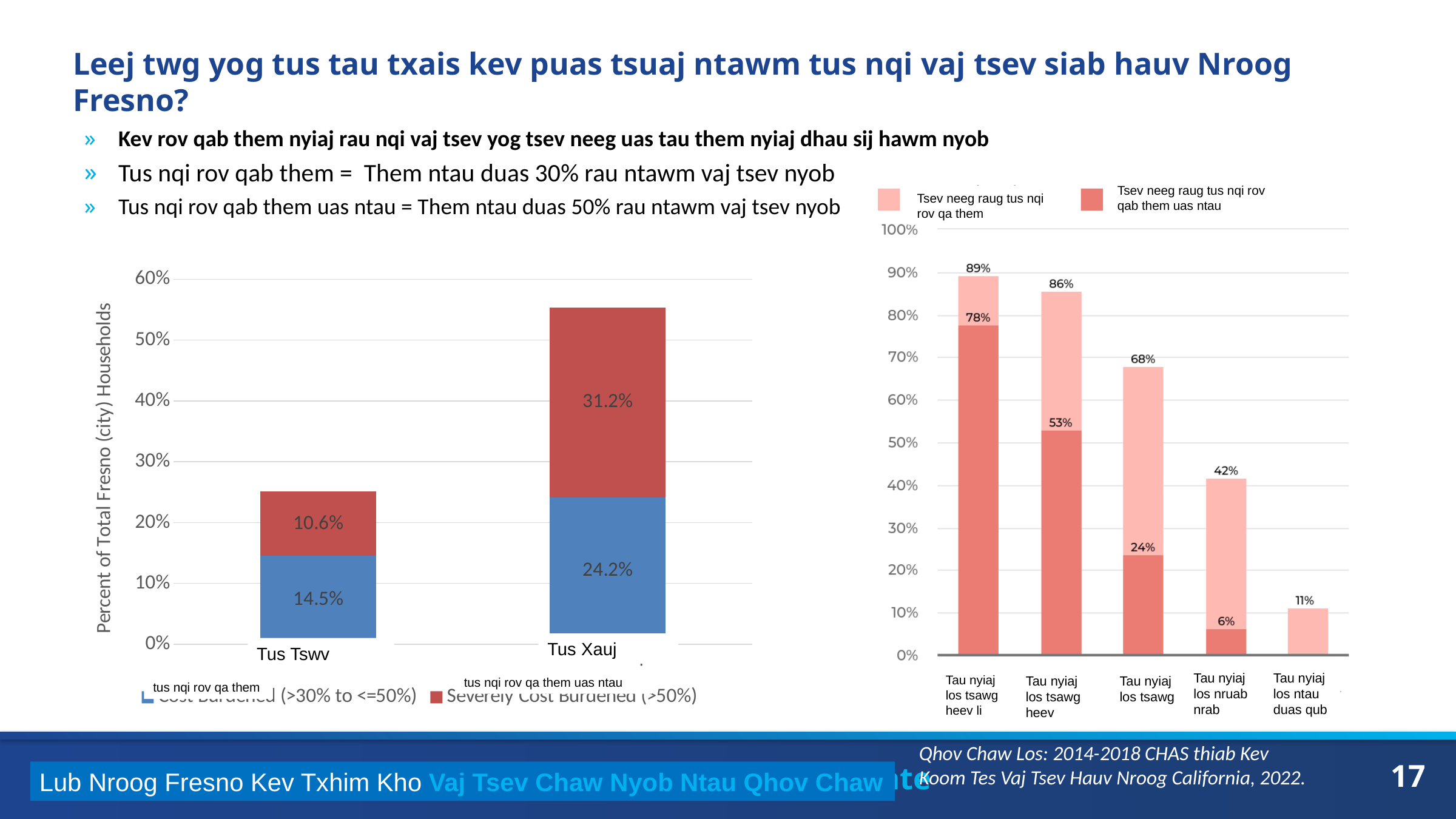
In the left chart, which category has the taller stacked bar, Tus Tswv or Tus Xauj? Tus Xauj In the right chart, which category has the lowest bar? Tau nyiaj los ntau duas qub How many series does the legend of the right chart list? 2 In the right chart, how many categories are shown on the x axis? 5 In the left chart, what is the value of the blue segment for Tus Tswv? 14.5% In the right chart, what is the value labelled at the top of the bar for Tau nyiaj los tsawg heev li? 89% In the right chart, do the bar heights rise or fall from left to right across the categories? Fall In the right chart, what is the value of the dark red segment for Tau nyiaj los tsawg? 24% In the left chart, what is the value of the red segment for Tus Xauj? 31.2% In the left chart, what is the difference between the blue segments for Tus Xauj and Tus Tswv? 9.7% In the left chart, what is the total of the stacked bar for Tus Xauj? 55.4% What kind of chart is the left chart? Stacked bar chart